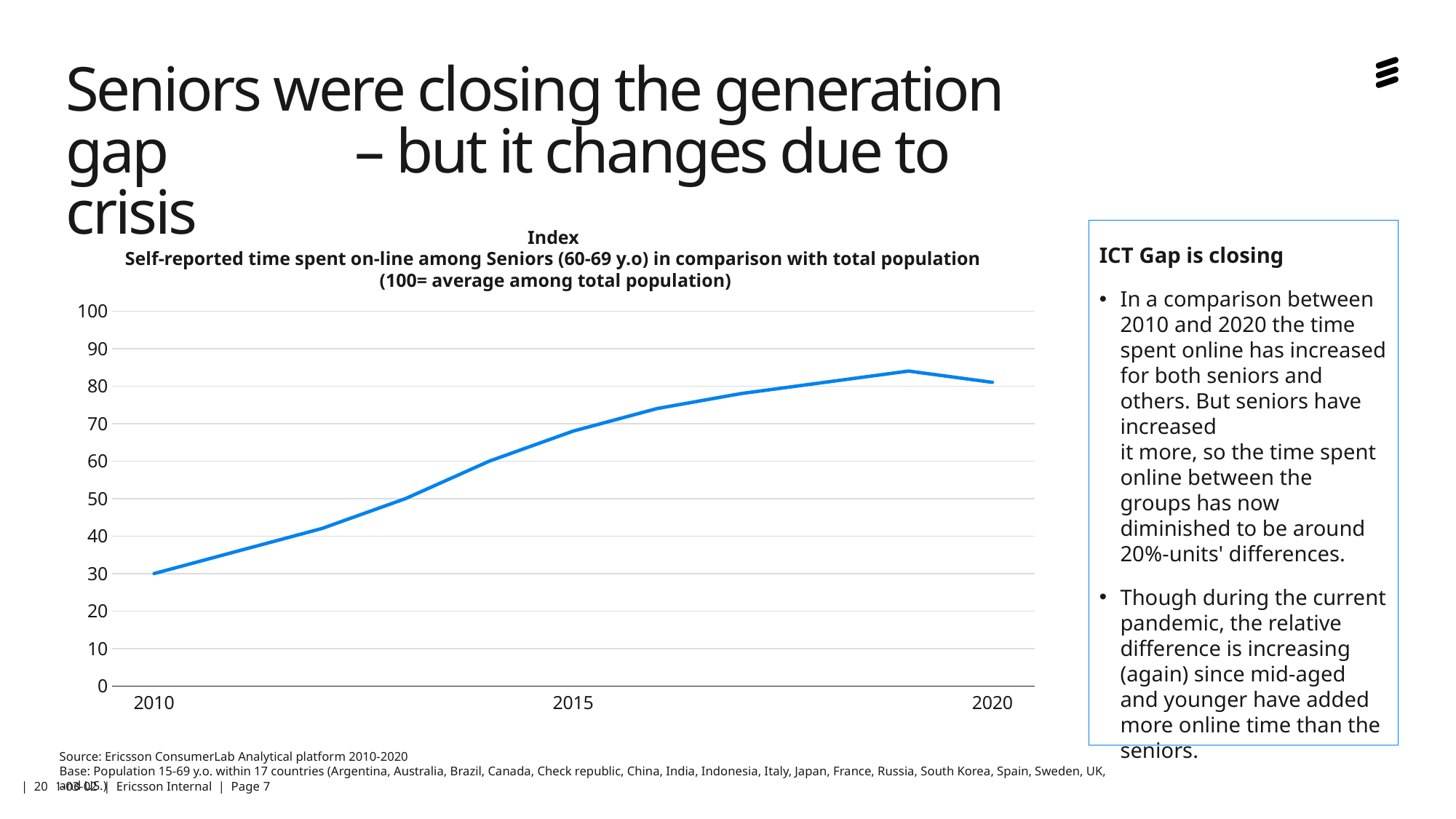
Which year has the larger index value, 2010 or 2020? 2020 Of the years labelled on the x axis, which has the lowest index value? 2010 Which year has the larger index value, 2015 or 2020? 2020 Is the index value for 2020 greater or less than 90? less Is the index value for 2015 greater or less than 60? greater How many years are labelled on the x axis of the chart? 3 Is the index value for 2010 greater or less than 40? less What kind of chart is shown on the slide? line chart Does the index value rise or fall between 2010 and 2015? rise According to the chart subtitle, what index value represents the average among the total population? 100 What is the highest value shown on the chart's vertical axis? 100